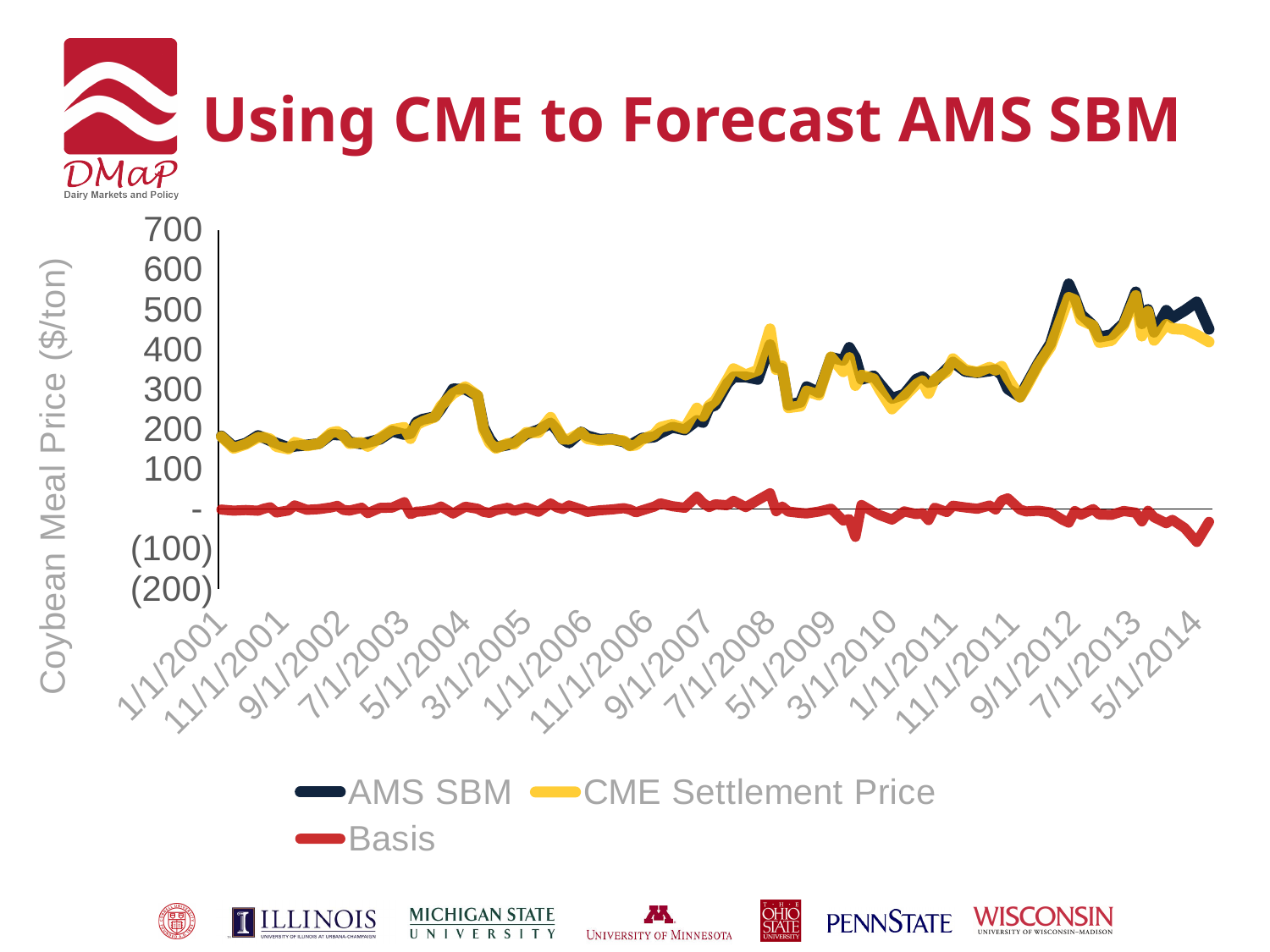
Is the AMS SBM value at 1/1/2001 greater or less than 300? less Is the peak AMS SBM value around 9/1/2012 greater or less than 500? greater Overall, does the AMS SBM series rise or fall from 1/1/2001 to 5/1/2014? rise What are the three series named in the legend? AMS SBM, CME Settlement Price, Basis What is the highest tick value shown on the vertical axis? 700 How many series does the legend list? 3 Which series stays closest to zero across the whole period? Basis What kind of chart is shown on the slide? line chart What is the label on the vertical axis? Coybean Meal Price ($/ton) Which is larger at 7/1/2013, the AMS SBM value or the Basis value? AMS SBM Is the Basis value at the end of the series near 5/1/2014 greater or less than 0? less How many date labels are shown on the x axis? 17